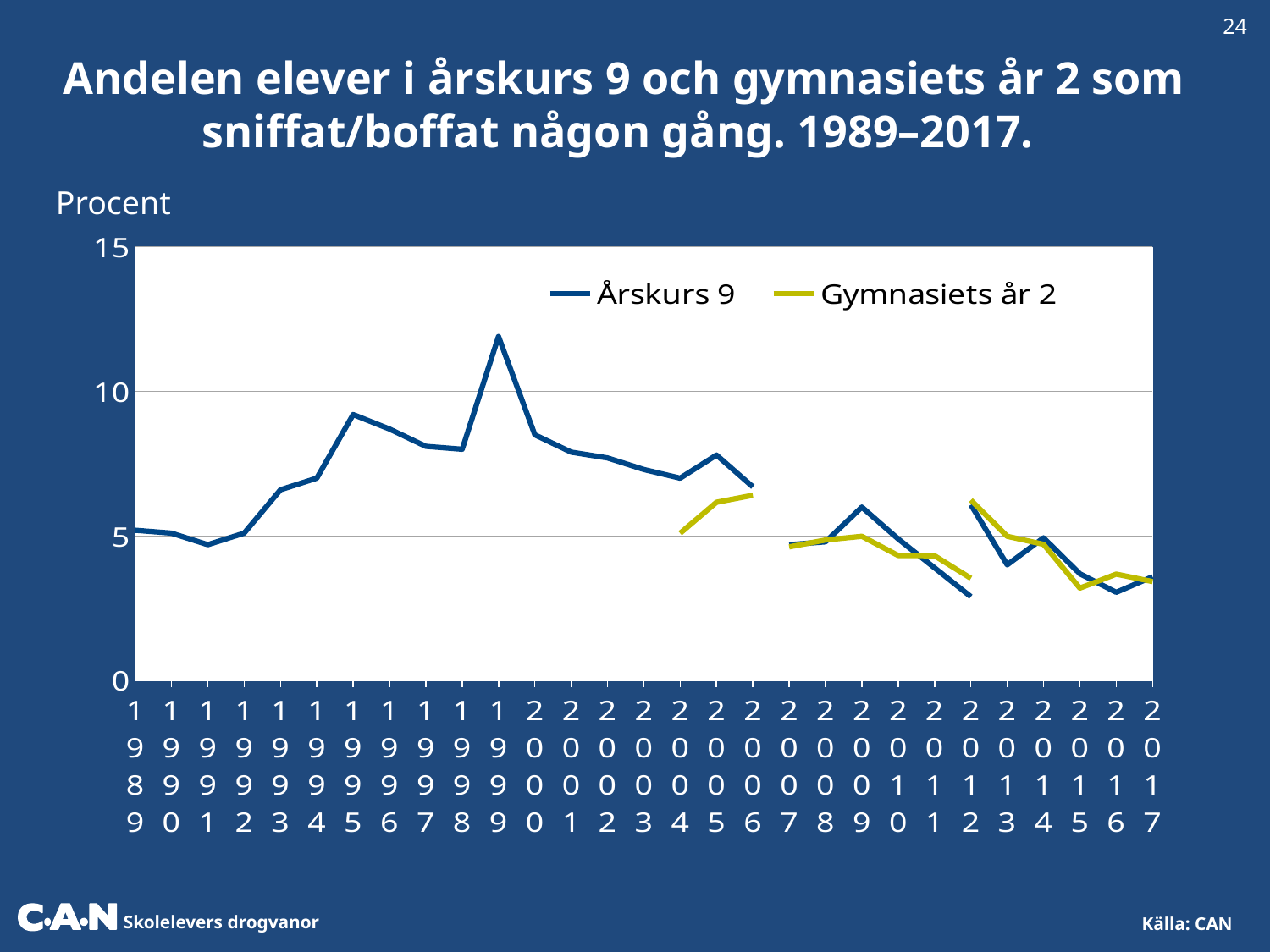
In which year does the Årskurs 9 series reach its highest value? 1999 What are the two series named in the legend? Årskurs 9 and Gymnasiets år 2 Does the Årskurs 9 series rise or fall between 1999 and 2004? Fall How many years are shown along the x axis? 29 How many series does the legend list? 2 What kind of chart is shown on the slide? Line chart Is the value for Gymnasiets år 2 in 2015 greater or less than 5? less What is the label on the vertical axis? Procent In 2005, which series has the higher value, Årskurs 9 or Gymnasiets år 2? Årskurs 9 Is the value for Årskurs 9 in 1999 greater or less than 10? greater